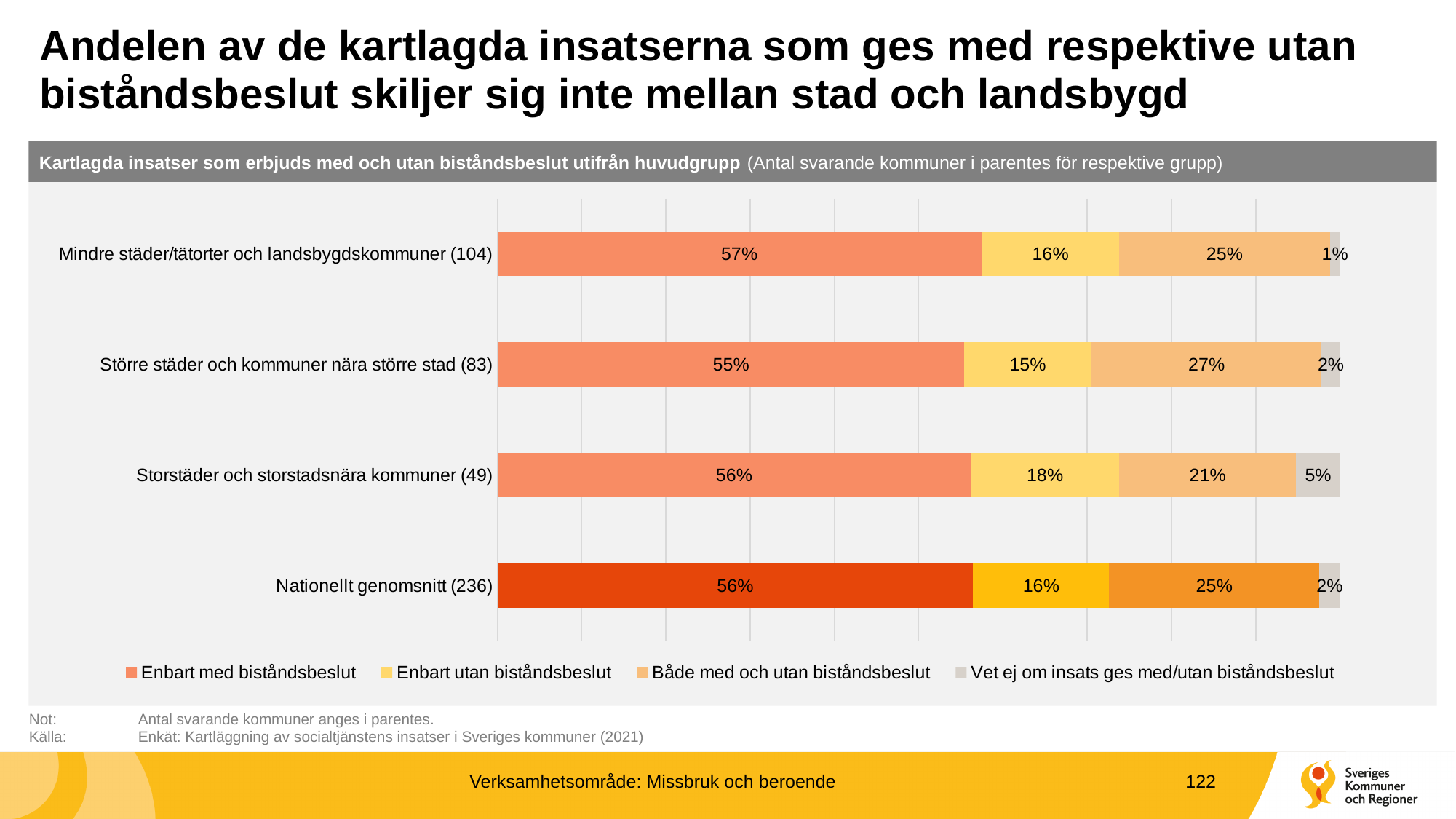
What percentage of insatser for Mindre städer/tätorter och landsbygdskommuner (104) are given Enbart med biståndsbeslut? 57% How many series does the legend list? 4 How many groups (bars) are shown in the chart? 4 Which group has the highest share of Enbart utan biståndsbeslut? Storstäder och storstadsnära kommuner (49) Which group has the lowest share of Vet ej om insats ges med/utan biståndsbeslut? Mindre städer/tätorter och landsbygdskommuner (104) Which group has the highest share of Både med och utan biståndsbeslut? Större städer och kommuner nära större stad (83) How many percentage points higher is Både med och utan biståndsbeslut for Större städer och kommuner nära större stad (83) than for Storstäder och storstadsnära kommuner (49)? 6 percentage points What kind of chart is shown on the slide? Stacked bar chart What is the value of Både med och utan biståndsbeslut for Större städer och kommuner nära större stad (83)? 27% What is the value of Vet ej om insats ges med/utan biståndsbeslut for Storstäder och storstadsnära kommuner (49)? 5% What is the value of Enbart utan biståndsbeslut for Nationellt genomsnitt (236)? 16% Which has a larger share of Enbart med biståndsbeslut: Mindre städer/tätorter och landsbygdskommuner (104) or Större städer och kommuner nära större stad (83)? Mindre städer/tätorter och landsbygdskommuner (104)